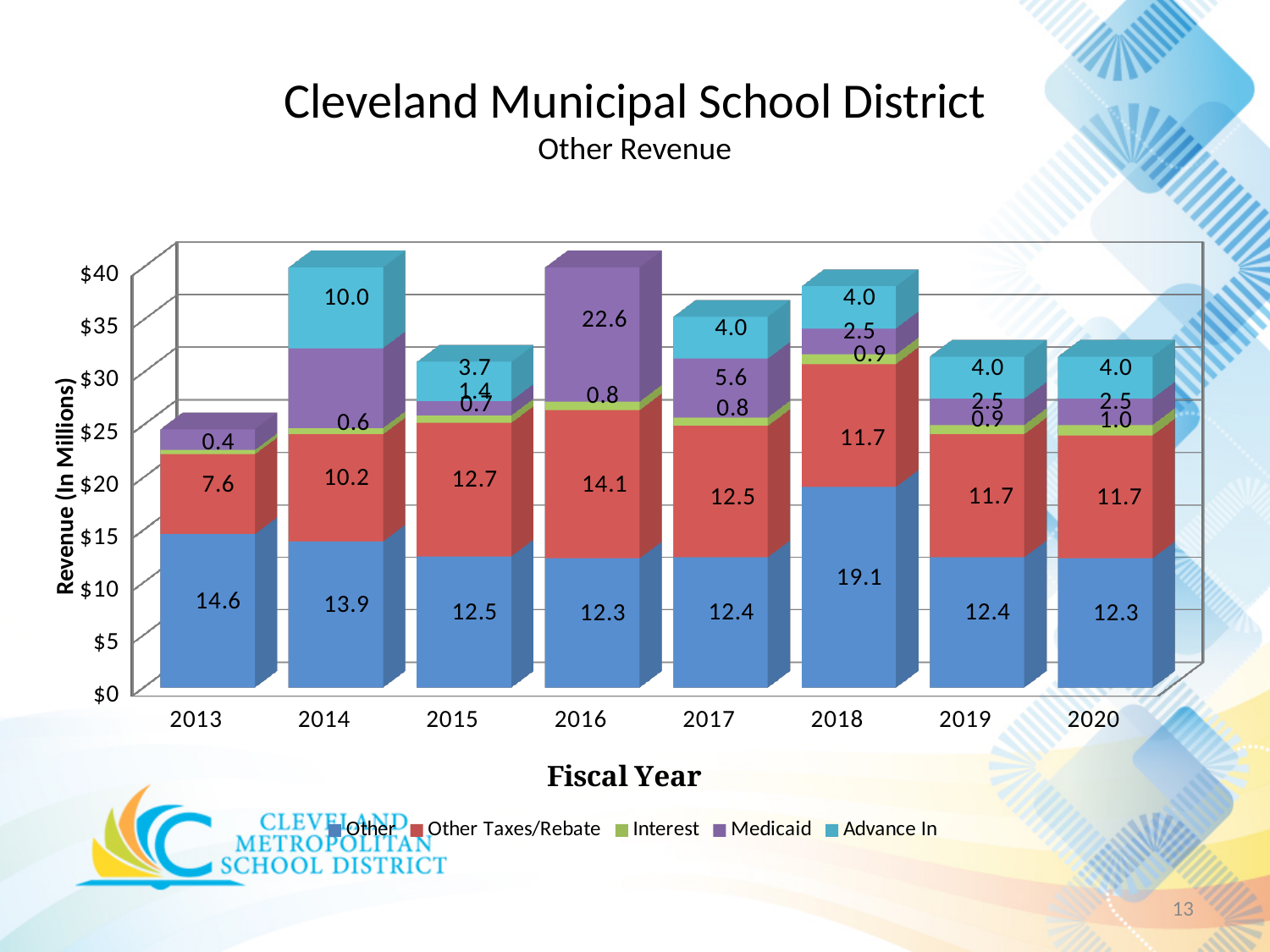
What is the value of the Other series for fiscal year 2018? 19.1 How many fiscal years are shown on the x axis? 8 Which fiscal year has the lowest Other Taxes/Rebate value? 2013 What is the label on the vertical axis of the chart? Revenue (In Millions) What kind of chart is shown on the slide? Stacked bar chart Which fiscal year has the highest value for the Other series? 2018 How much larger is the Other value in 2018 than in 2019? 6.7 How many series does the legend list? 5 What is the Advance In value for fiscal year 2014? 10.0 Which fiscal year has the larger Other Taxes/Rebate value, 2015 or 2016? 2016 What is the Medicaid value for fiscal year 2016? 22.6 What is the total of the stacked bar for fiscal year 2019? 31.5